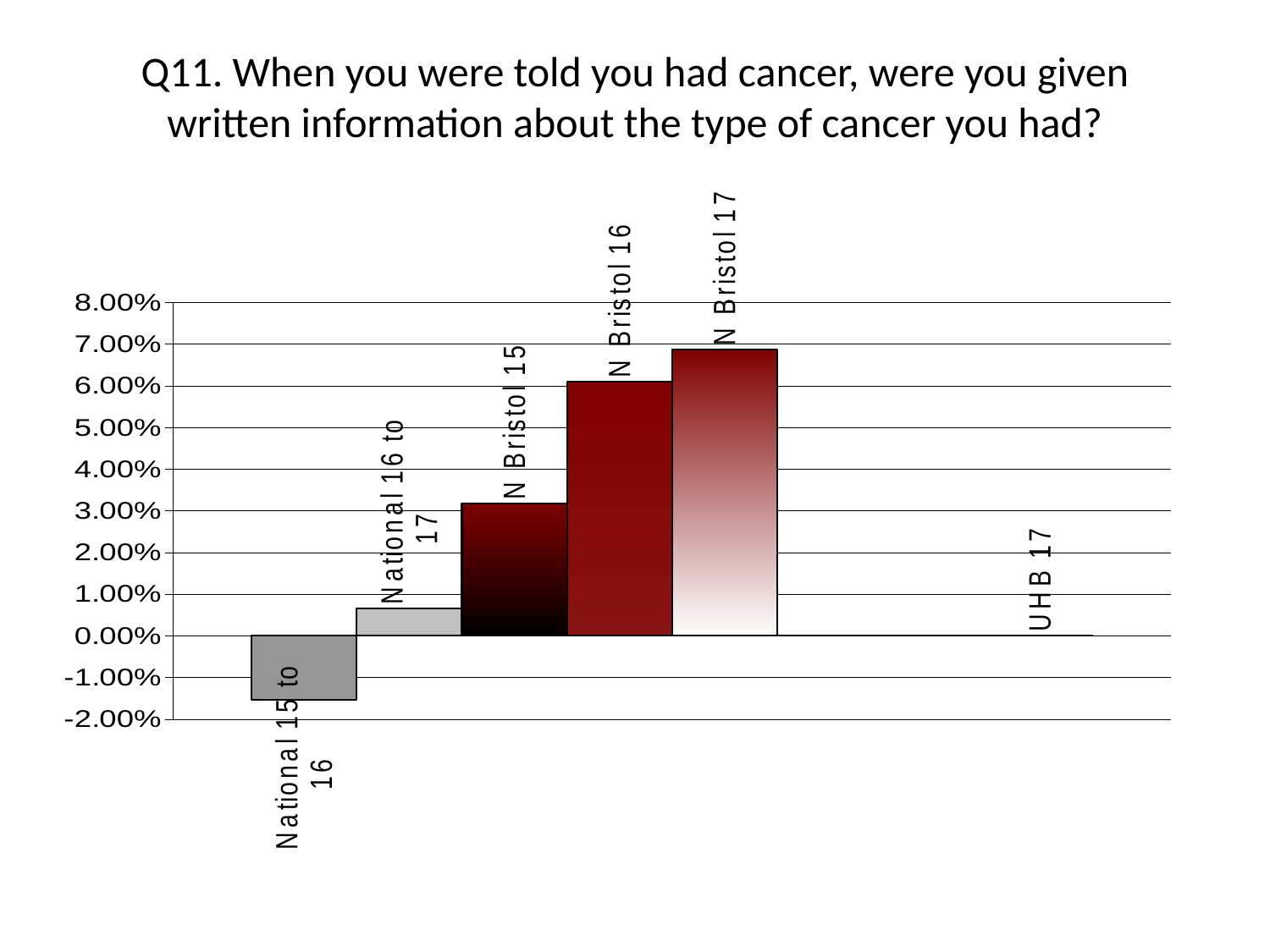
Is the value for N Bristol 15 greater or less than 2.00%? greater Do the values rise or fall from N Bristol 15 to N Bristol 17? rise Is the value for N Bristol 16 greater or less than 5.00%? greater Which category has the highest value? N Bristol 17 How many category labels are shown along the x axis? 6 Is the value for N Bristol 17 greater or less than 6.00%? greater What kind of chart is shown on the slide? Bar chart Which is larger, the value for N Bristol 15 or N Bristol 16? N Bristol 16 Which is larger, the value for National 15 to 16 or National 16 to 17? National 16 to 17 Which category has the lowest value? National 15 to 16